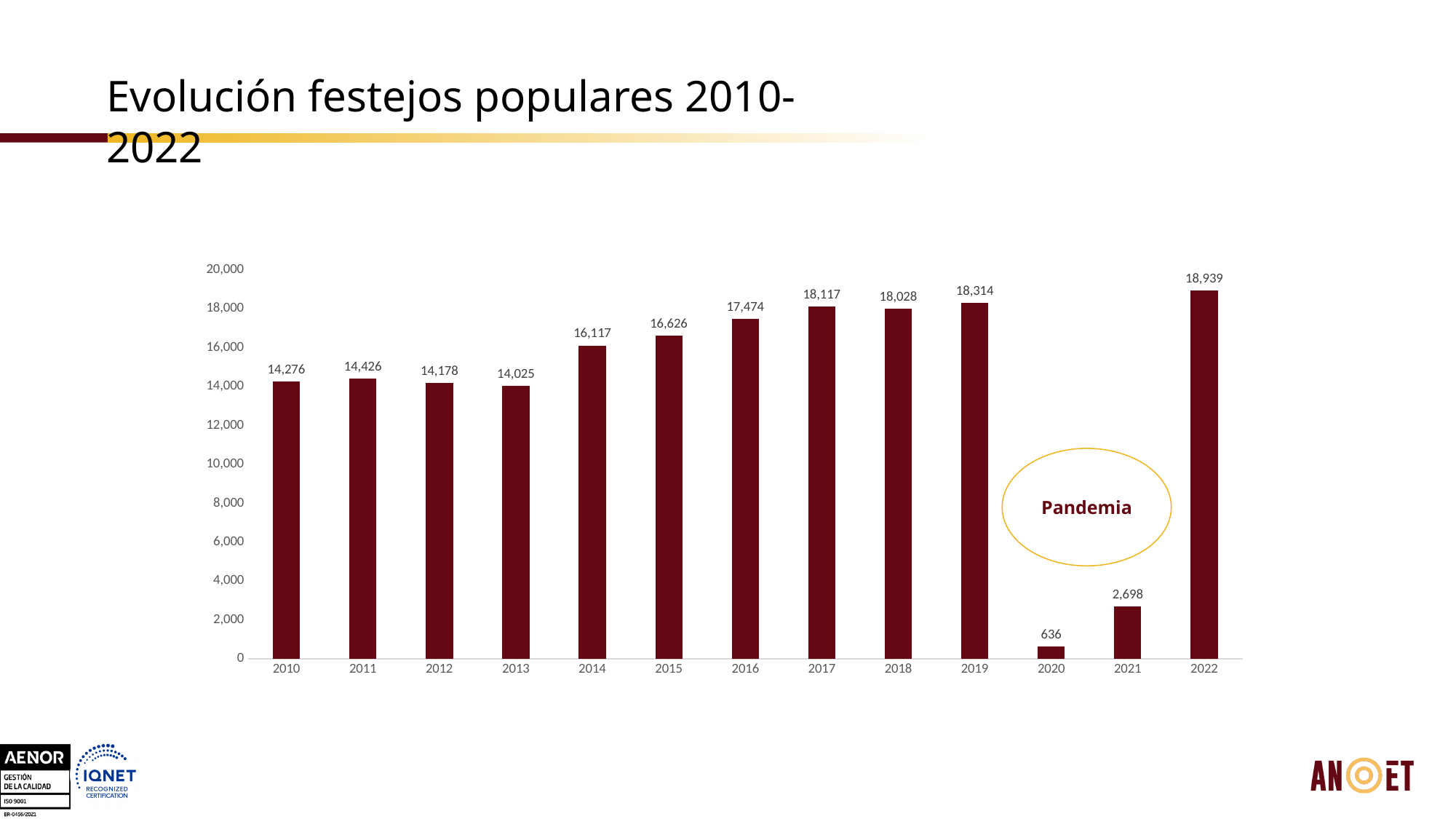
Which year has the highest value? 2022 What is the difference between the values for 2022 and 2019? 625 What word is written inside the circle annotation on the chart? Pandemia What is the value for 2022? 18,939 What is the value for 2010? 14,276 What is the difference between the values for 2021 and 2020? 2,062 What kind of chart is shown on the slide? Bar chart Which is larger, the value for 2017 or the value for 2018? 2017 Is the value for 2014 greater or less than 16,000? greater How many years are shown on the x axis? 13 Which year has the lowest value? 2020 What is the value for 2020? 636